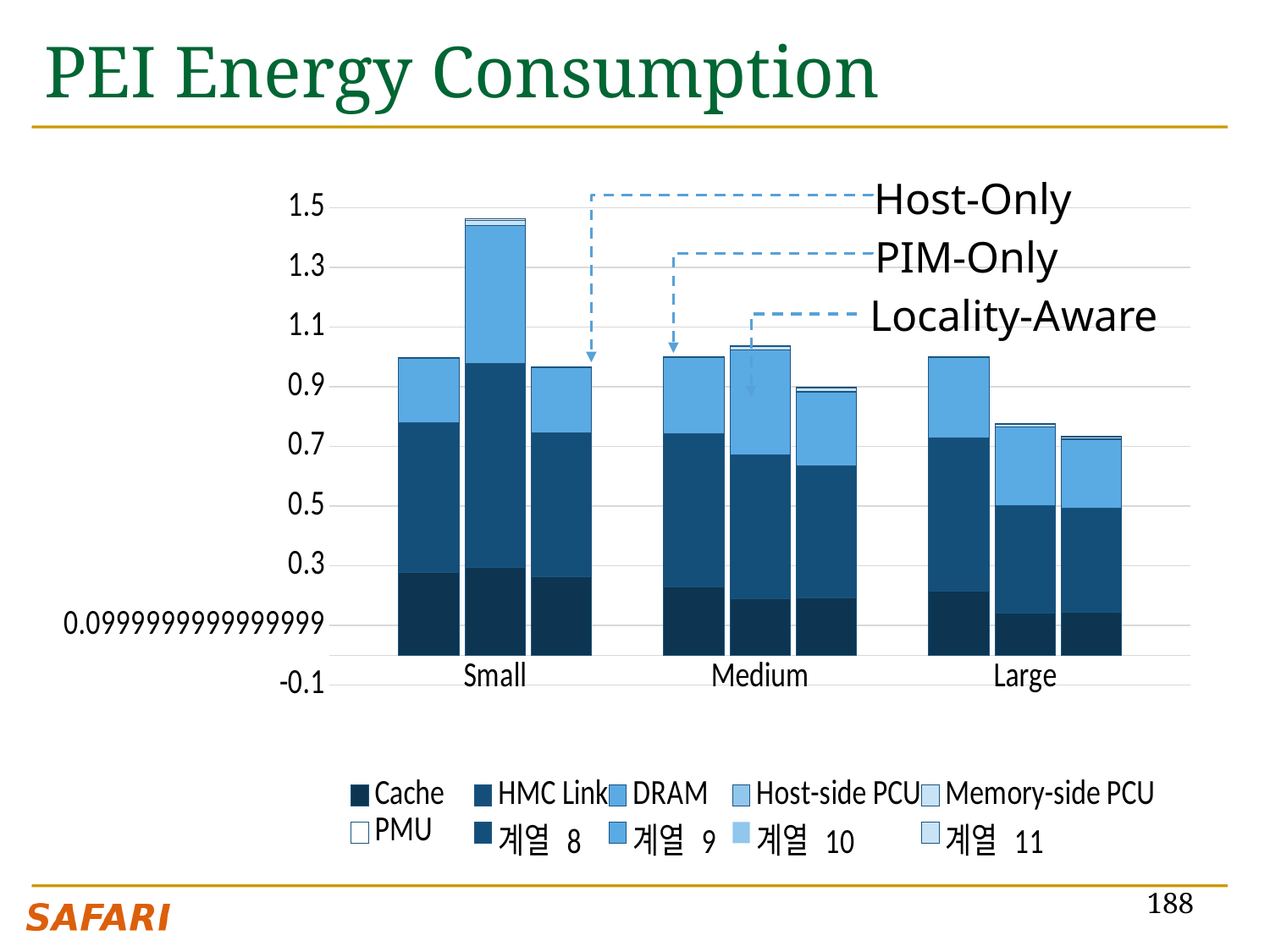
For Small, which bar is taller: PIM-Only or Locality-Aware? PIM-Only Which category has the lowest Locality-Aware bar? Large How many categories are shown on the x axis of the chart? 3 Is the total of the PIM-Only bar for Medium greater or less than 0.9? greater How many series does the chart's legend list? 10 Is the total of the Locality-Aware bar for Large greater or less than 0.9? less Which bar in the chart is the tallest overall? PIM-Only for Small What kind of chart is shown on the slide? stacked bar chart For Large, which bar is taller: Host-Only or Locality-Aware? Host-Only What is the title of the slide containing the chart? PEI Energy Consumption Is the total of the Host-Only bar for Small greater or less than 1.3? less Do the Locality-Aware bars rise or fall from Small to Large? fall